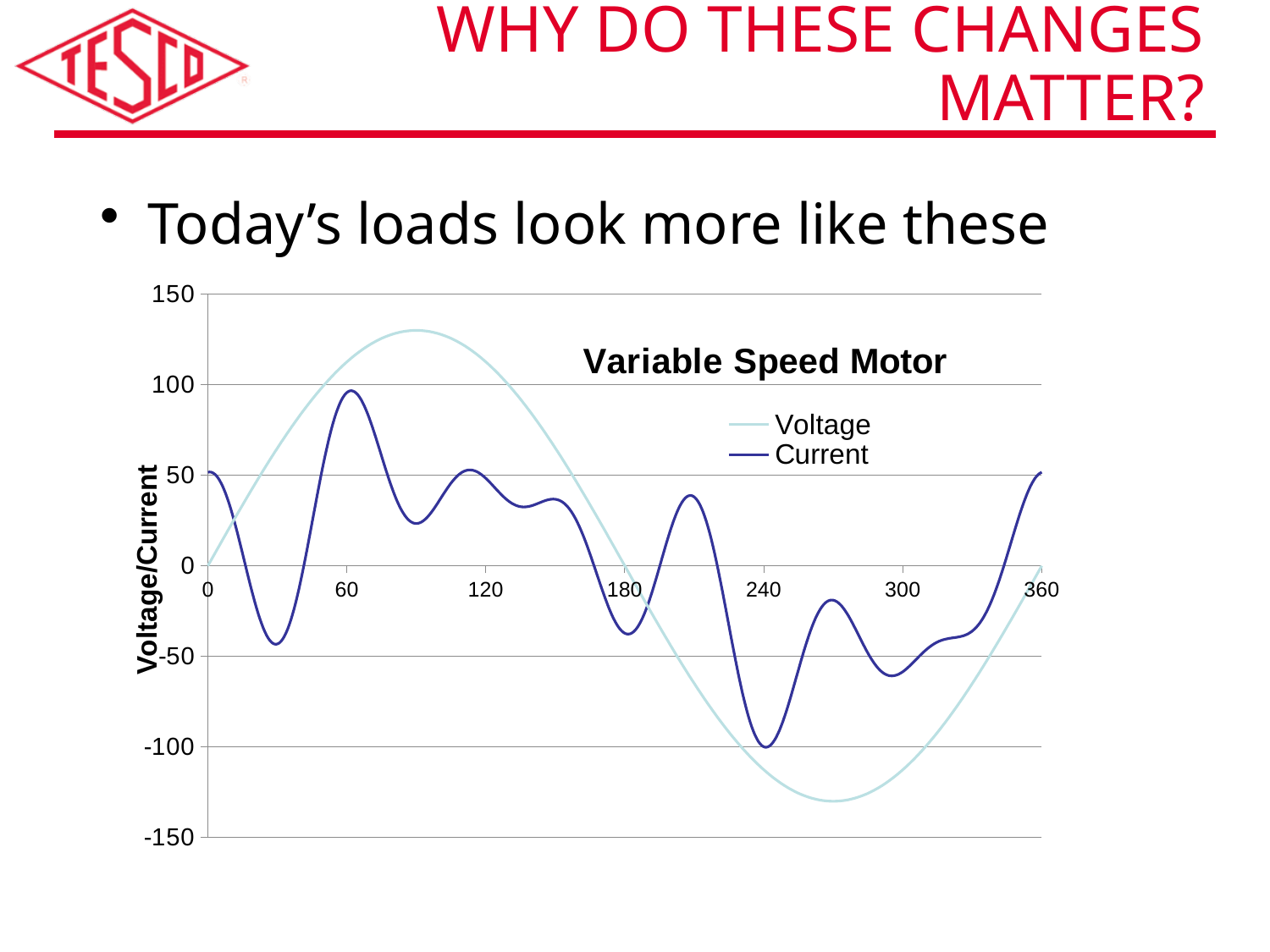
At x = 90, which series has the larger value, Voltage or Current? Voltage Is the Voltage value at x = 270 greater or less than -100? less What is the Voltage value at x = 0? 0 What is the Voltage value at x = 180? 0 What is the label on the vertical axis of the chart? Voltage/Current Is the Voltage value at x = 90 greater or less than 100? greater How many series does the chart legend list? 2 What is the title of the chart? Variable Speed Motor Is the Current value at x = 60 greater or less than 50? greater Which series reaches the higher peak value on the chart? Voltage What kind of chart is shown on the slide? line chart